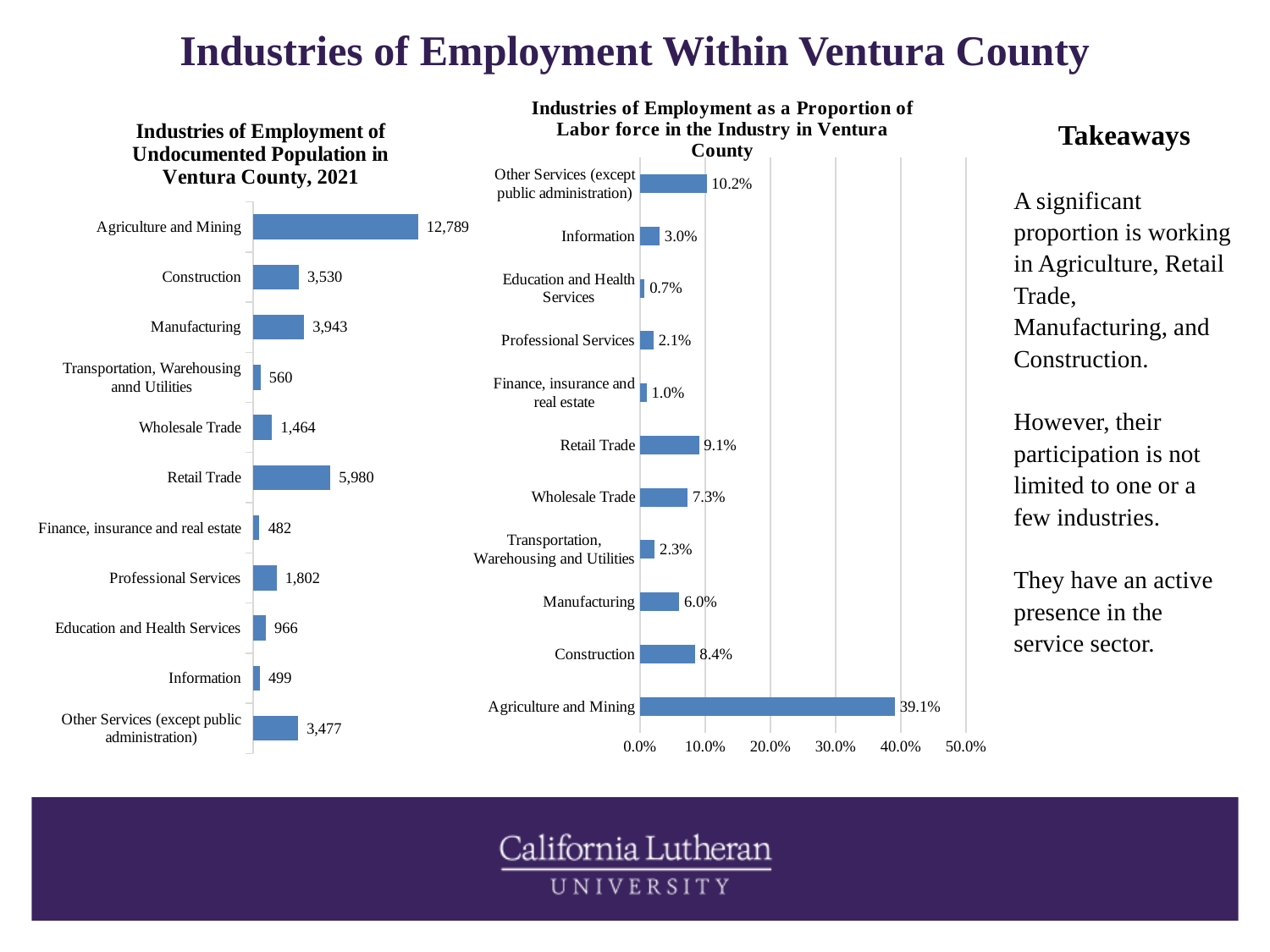
In the 'Industries of Employment as a Proportion of Labor force in the Industry in Ventura County' chart, which industry has the highest proportion? Agriculture and Mining In the 'Industries of Employment of Undocumented Population in Ventura County, 2021' chart, what is the value for Agriculture and Mining? 12,789 In the 'Industries of Employment of Undocumented Population in Ventura County, 2021' chart, what is the difference between Manufacturing and Construction? 413 In the 'Industries of Employment as a Proportion of Labor force in the Industry in Ventura County' chart, which industry has the lowest proportion? Education and Health Services In the 'Industries of Employment of Undocumented Population in Ventura County, 2021' chart, which is larger: Wholesale Trade or Professional Services? Professional Services In the 'Industries of Employment as a Proportion of Labor force in the Industry in Ventura County' chart, what is the difference between Other Services (except public administration) and Retail Trade? 1.1% What type of chart is the 'Industries of Employment as a Proportion of Labor force in the Industry in Ventura County' chart? Bar chart In the 'Industries of Employment as a Proportion of Labor force in the Industry in Ventura County' chart, is the value for Agriculture and Mining greater or less than 30.0%? greater In the 'Industries of Employment of Undocumented Population in Ventura County, 2021' chart, which industry has the lowest value? Finance, insurance and real estate In the 'Industries of Employment as a Proportion of Labor force in the Industry in Ventura County' chart, what is the value for Construction? 8.4% How many industries are shown in the 'Industries of Employment of Undocumented Population in Ventura County, 2021' chart? 11 In the 'Industries of Employment of Undocumented Population in Ventura County, 2021' chart, what is the value for Retail Trade? 5,980